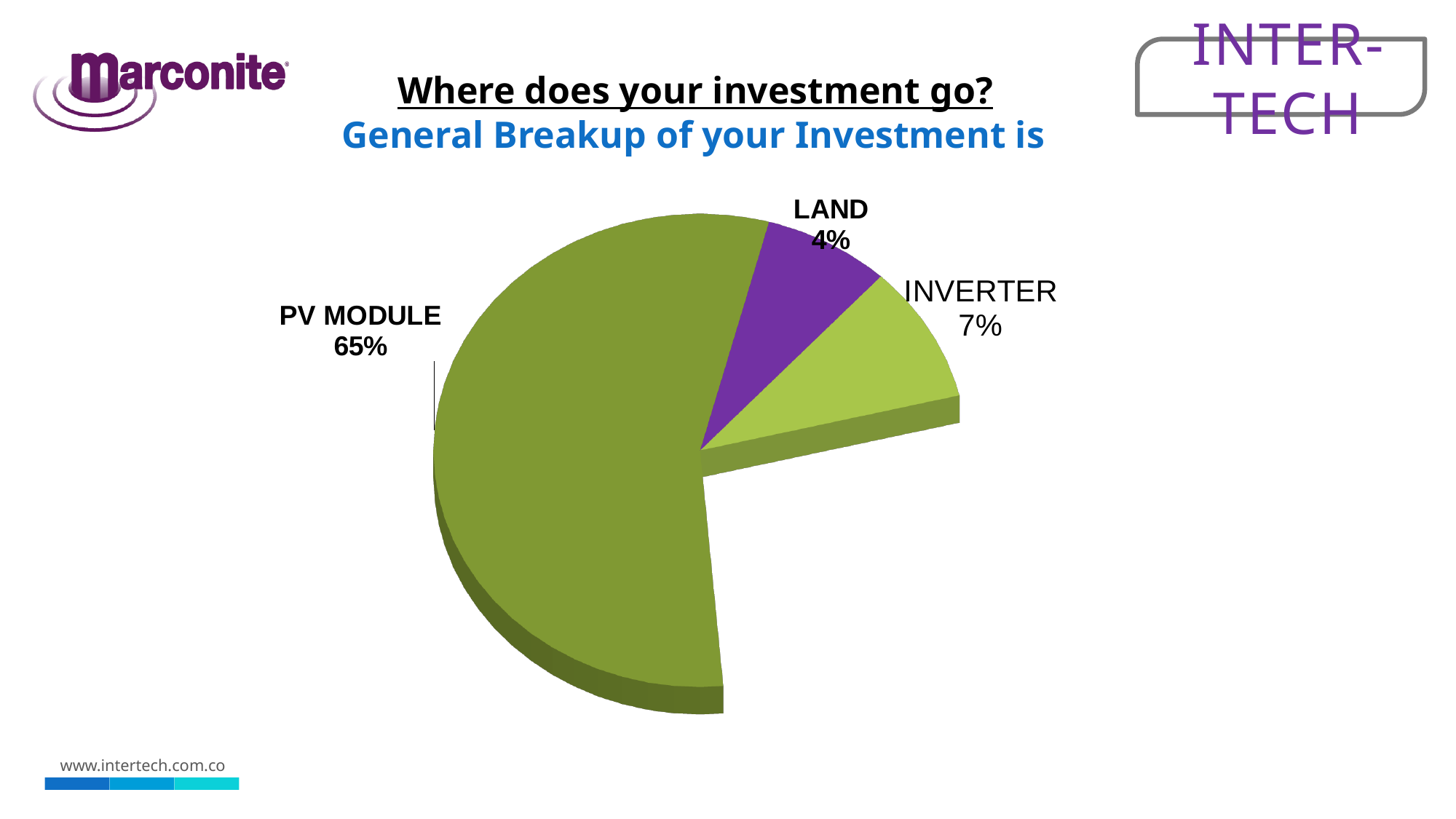
How many labelled slices does the pie chart have? 3 What percentage of the investment goes to PV MODULE? 65% Which labelled slice of the pie is the smallest? LAND Which labelled slice of the pie is the largest? PV MODULE Which is larger, the INVERTER share or the LAND share? INVERTER What percentage of the investment goes to LAND? 4% What is the difference in percentage points between PV MODULE and INVERTER? 58 What is the difference in percentage points between INVERTER and LAND? 3 What share of the pie does the PV MODULE slice represent? 65% What percentage of the investment goes to INVERTER? 7% What kind of chart is shown on the slide? Pie chart What is the blue subtitle above the chart? General Breakup of your Investment is